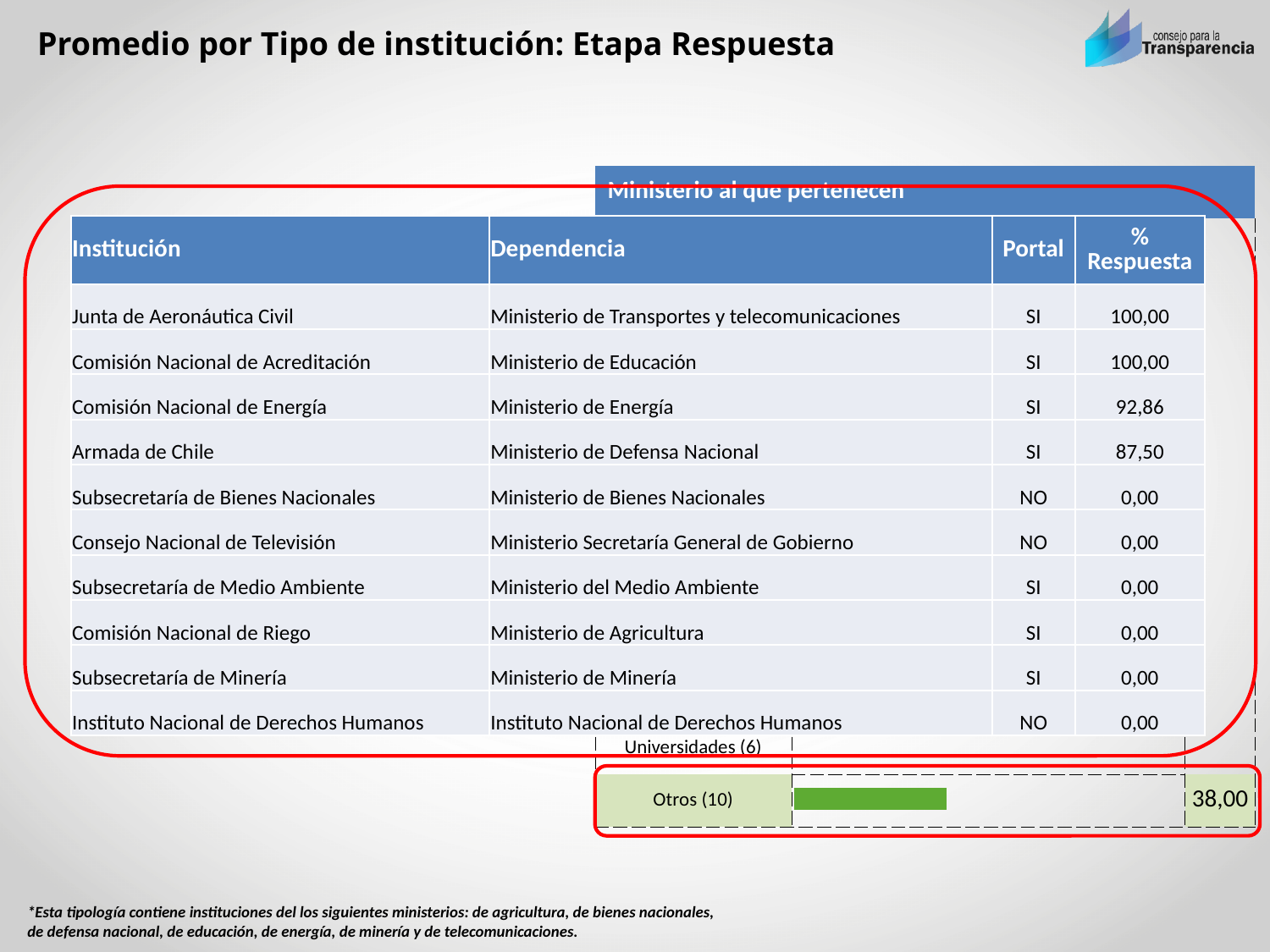
Which category label appears directly above Otros (10) in the bar chart at the bottom of the slide? Universidades (6) In the bar chart at the bottom of the slide, is the value for Otros (10) greater or less than 50? less In the bar chart at the bottom of the slide, what is the value shown for Otros (10)? 38,00 What kind of chart is partially visible at the bottom of the slide, below the table? bar chart What colour is the bar for Otros (10) in the chart at the bottom of the slide? green